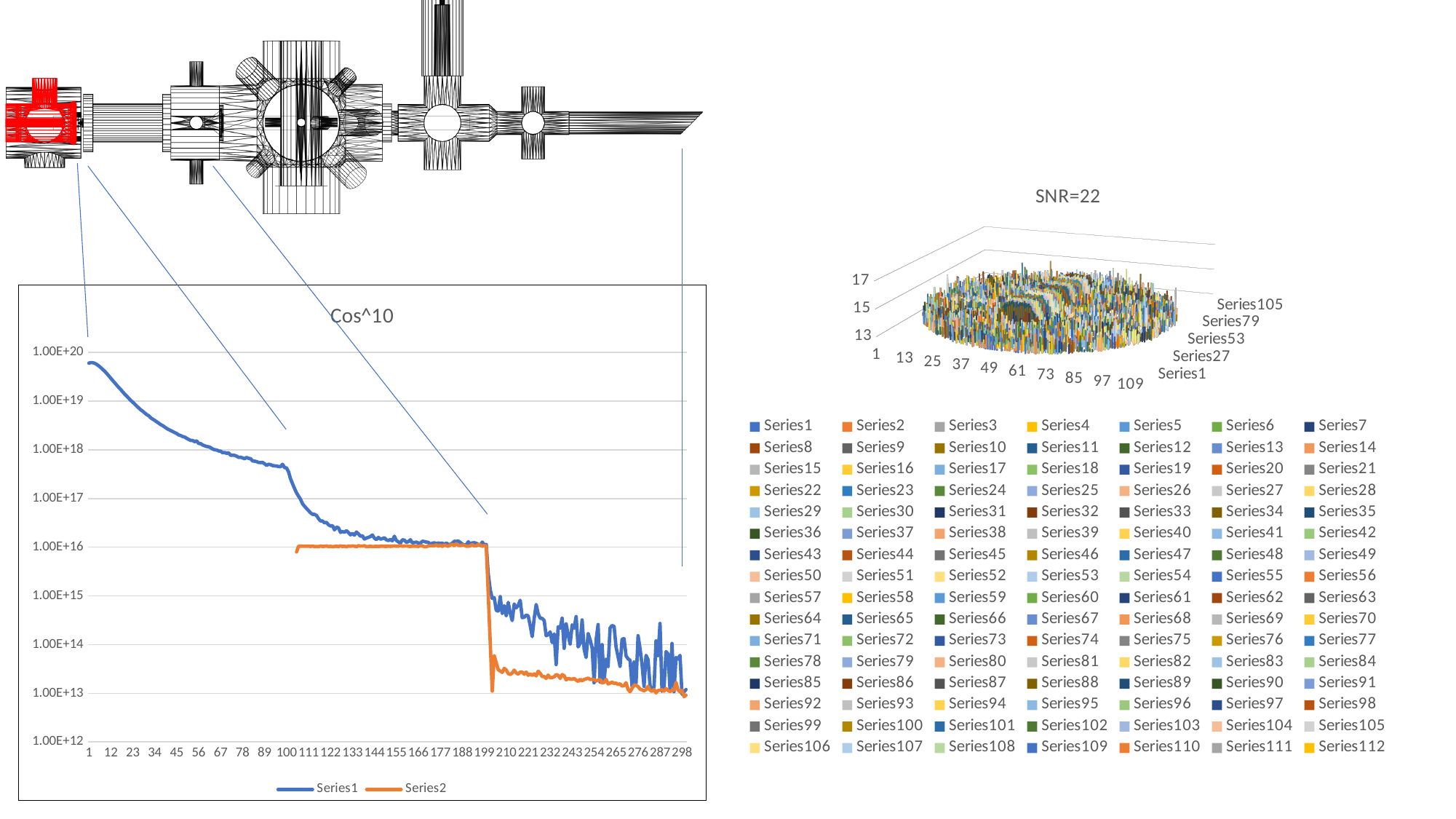
In the "Cos^10" chart, is the value of Series1 at x = 100 greater or less than 1.00E+17? greater What is the lowest tick label on the y axis of the "Cos^10" chart? 1.00E+12 In the "Cos^10" chart, is the value of Series1 at x = 1 greater or less than 1.00E+19? greater What is the title of the chart on the right side of the slide? SNR=22 In the "Cos^10" chart, does Series1 rise or fall as the x axis increases? fall What kind of chart is the chart titled "Cos^10"? line chart How many series does the legend of the "SNR=22" chart list? 112 What colour is the Series1 line in the "Cos^10" chart? blue In the "Cos^10" chart, is the value of Series2 at x = 298 greater or less than 1.00E+14? less What kind of chart is the chart titled "SNR=22"? 3D bar chart How many series does the legend of the "Cos^10" chart list? 2